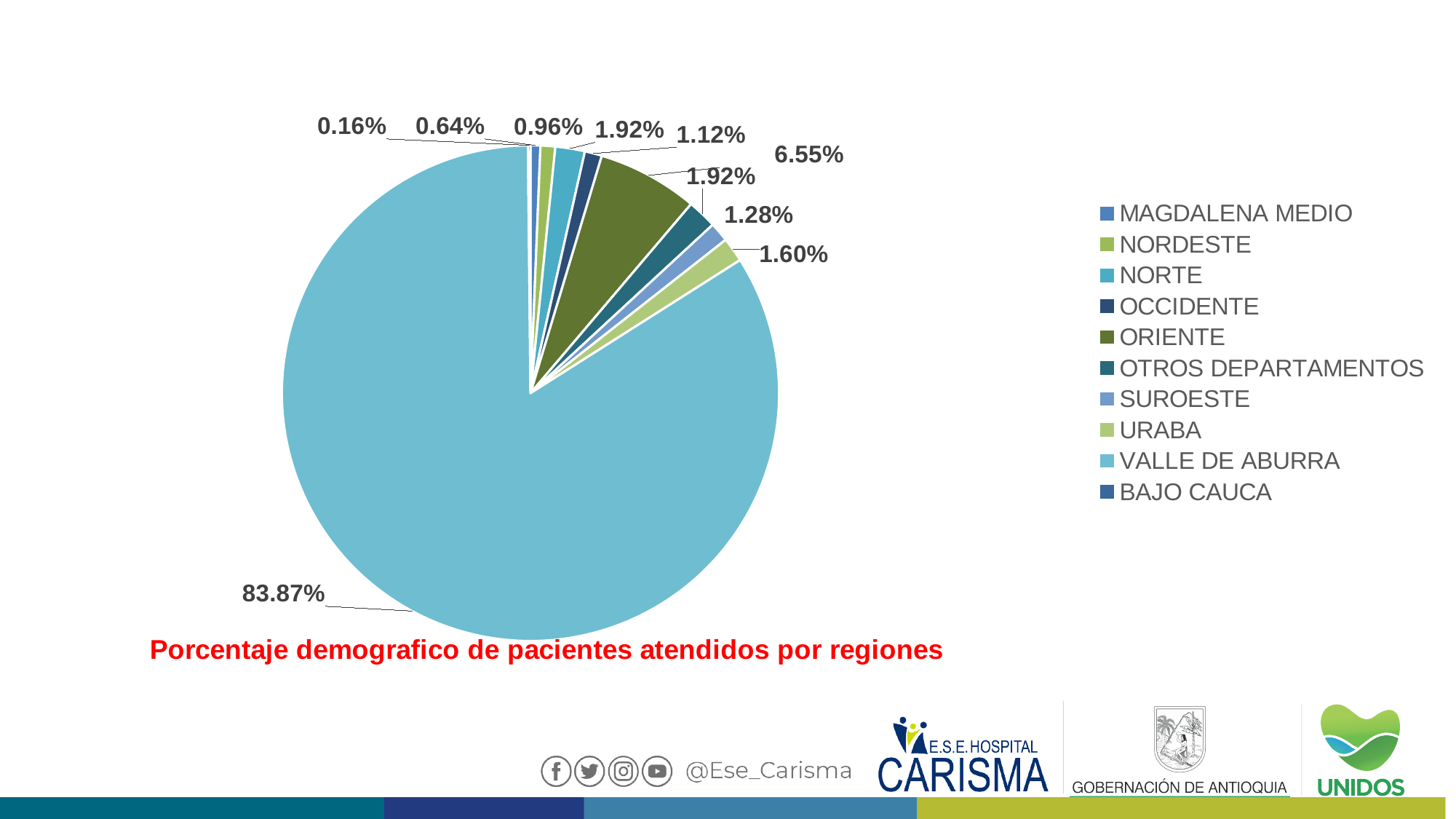
What is the share for NORDESTE? 0.96% What type of chart is shown on the slide? pie chart What is the title of the chart? Porcentaje demografico de pacientes atendidos por regiones Which is larger, the share for ORIENTE or the share for URABA? ORIENTE What percentage of patients is attributed to VALLE DE ABURRA? 83.87% How many regions does the legend list? 10 What is the difference between the shares of VALLE DE ABURRA and ORIENTE? 77.32% What is the share for URABA? 1.60% What is the share for ORIENTE? 6.55% Which region has the largest share of the pie? VALLE DE ABURRA Which region has the smallest share of the pie? BAJO CAUCA What is the share for MAGDALENA MEDIO? 0.64%